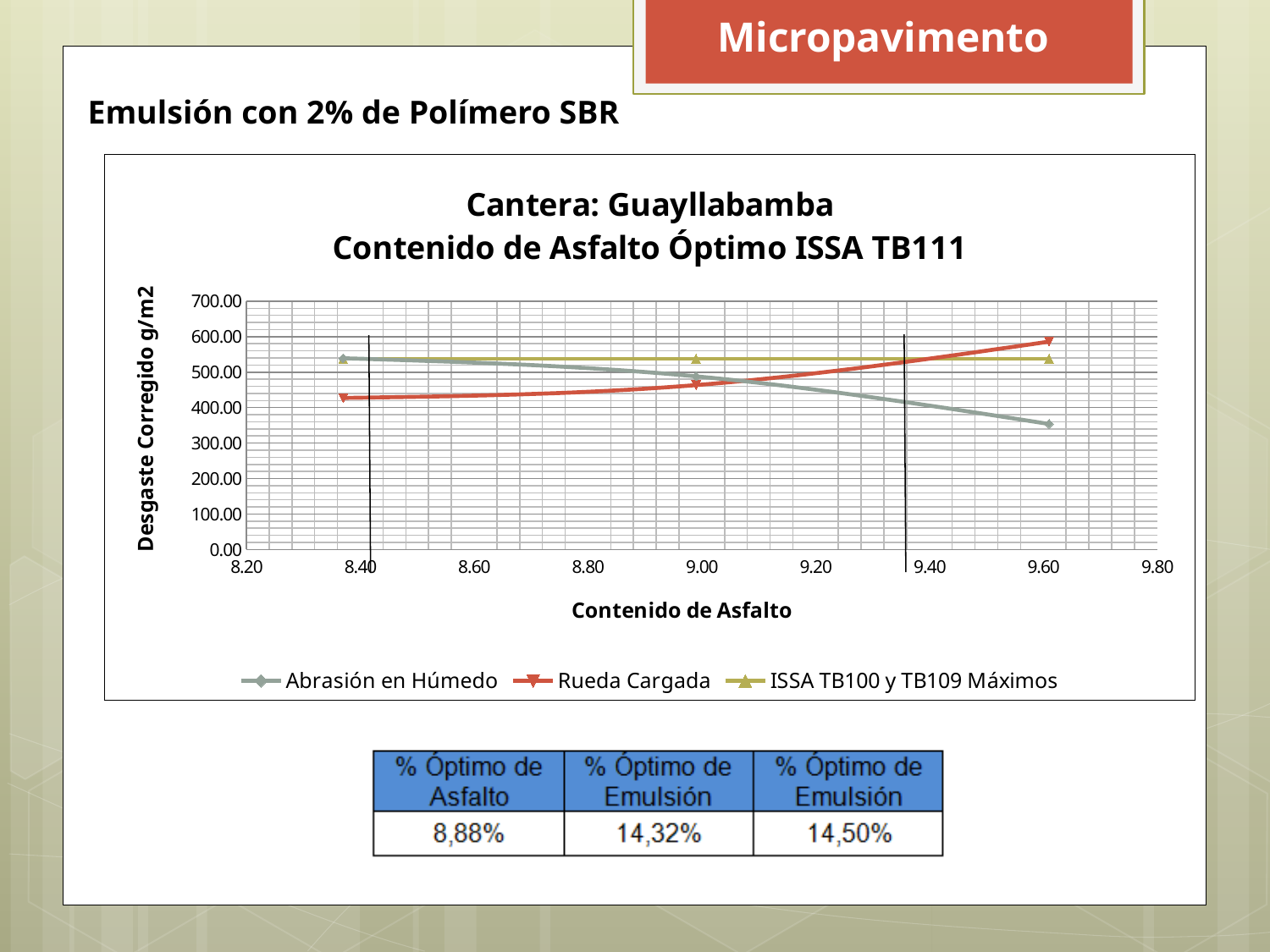
What is the label of the chart's x axis? Contenido de Asfalto At the rightmost point (near 9.60), which series has the larger value: Rueda Cargada or Abrasión en Húmedo? Rueda Cargada Is the value of Abrasión en Húmedo at its rightmost point (near 9.60) greater or less than 400.00? less What is the label of the chart's y axis? Desgaste Corregido g/m2 How many series does the chart legend list? 3 Does the Abrasión en Húmedo series rise or fall as Contenido de Asfalto increases? fall How many data points does the Abrasión en Húmedo series have? 3 At the leftmost point (near 8.40), which series has the larger value: Abrasión en Húmedo or Rueda Cargada? Abrasión en Húmedo Is the value of Rueda Cargada at its rightmost point (near 9.60) greater or less than 500.00? greater Is the value of Rueda Cargada at its leftmost point (near 8.40) greater or less than 500.00? less What kind of chart is shown on the slide? line chart Does the Rueda Cargada series rise or fall as Contenido de Asfalto increases? rise